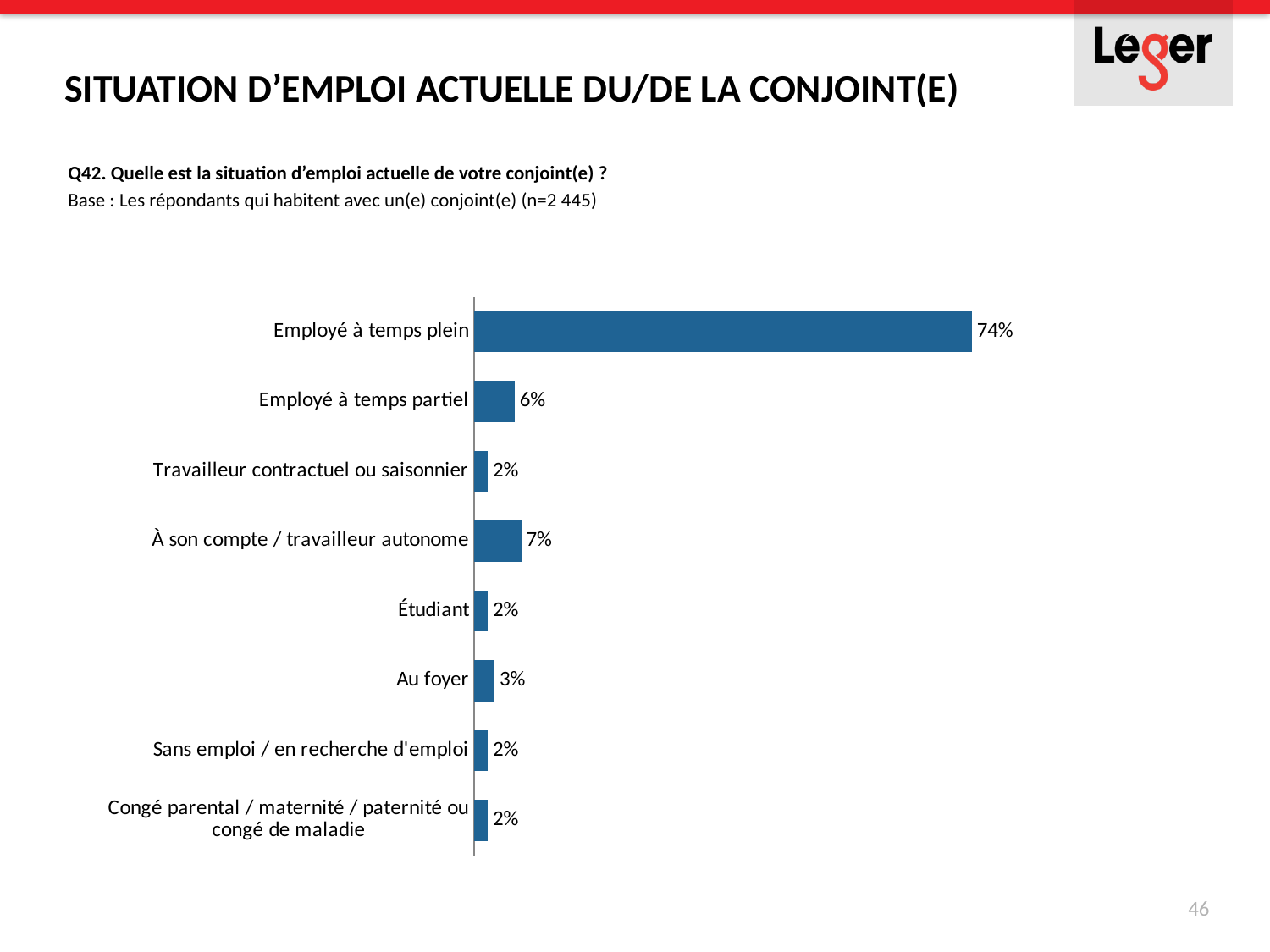
What is the difference between "Employé à temps plein" and "Employé à temps partiel"? 68% What is the difference between "À son compte / travailleur autonome" and "Au foyer"? 4% Which is larger, "Au foyer" or "Étudiant"? Au foyer What is the value for "Employé à temps partiel"? 6% What is the value for "À son compte / travailleur autonome"? 7% What kind of chart is shown on the slide? Bar chart Which category has the highest value? Employé à temps plein Which is larger, "À son compte / travailleur autonome" or "Employé à temps partiel"? À son compte / travailleur autonome How many categories are shown in the chart? 8 What is the value for "Employé à temps plein"? 74% How many categories have a value of 2%? 4 What is the value for "Au foyer"? 3%